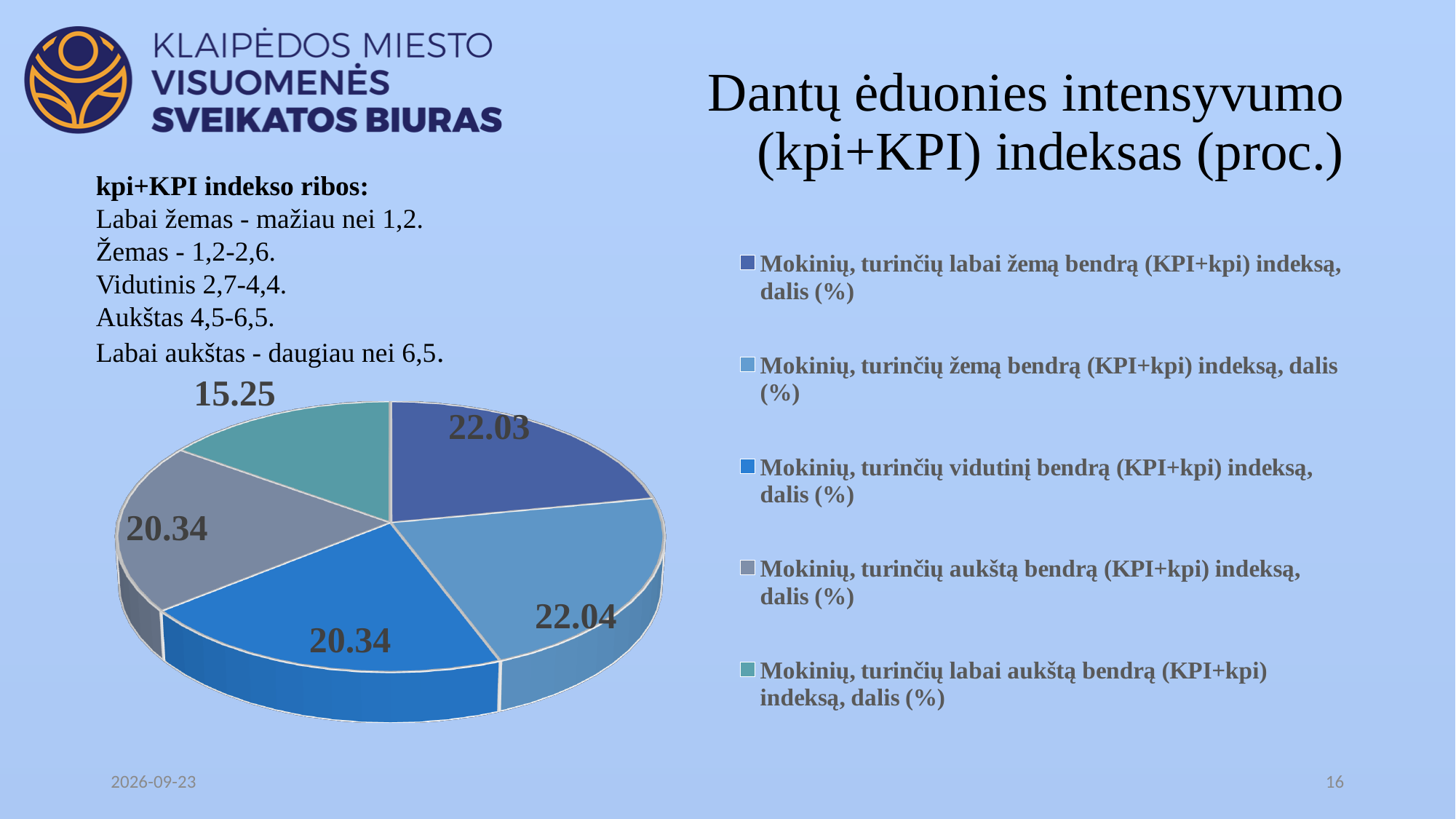
How many entries does the legend of the pie chart list? 5 What is the value for the slice 'Mokinių, turinčių vidutinį bendrą (KPI+kpi) indeksą, dalis (%)'? 20.34 What type of chart is shown on the slide? pie chart What is the title of the chart on the slide? Dantų ėduonies intensyvumo (kpi+KPI) indeksas (proc.) How many slices does the pie chart have? 5 Which is larger: the slice for students with a very low (labai žemą) index or the slice for students with a very high (labai aukštą) index? labai žemą (22.03) What is the difference between the slice for students with a very low (labai žemą) index and the slice for students with a high (aukštą) index? 1.69 What is the value for the slice 'Mokinių, turinčių žemą bendrą (KPI+kpi) indeksą, dalis (%)'? 22.04 What is the difference between the slice for students with a low (žemą) index and the slice for students with a very high (labai aukštą) index? 6.79 Which slice of the pie chart is the smallest? Mokinių, turinčių labai aukštą bendrą (KPI+kpi) indeksą, dalis (%) What is the value for the slice 'Mokinių, turinčių labai aukštą bendrą (KPI+kpi) indeksą, dalis (%)'? 15.25 What is the value for the slice 'Mokinių, turinčių labai žemą bendrą (KPI+kpi) indeksą, dalis (%)'? 22.03